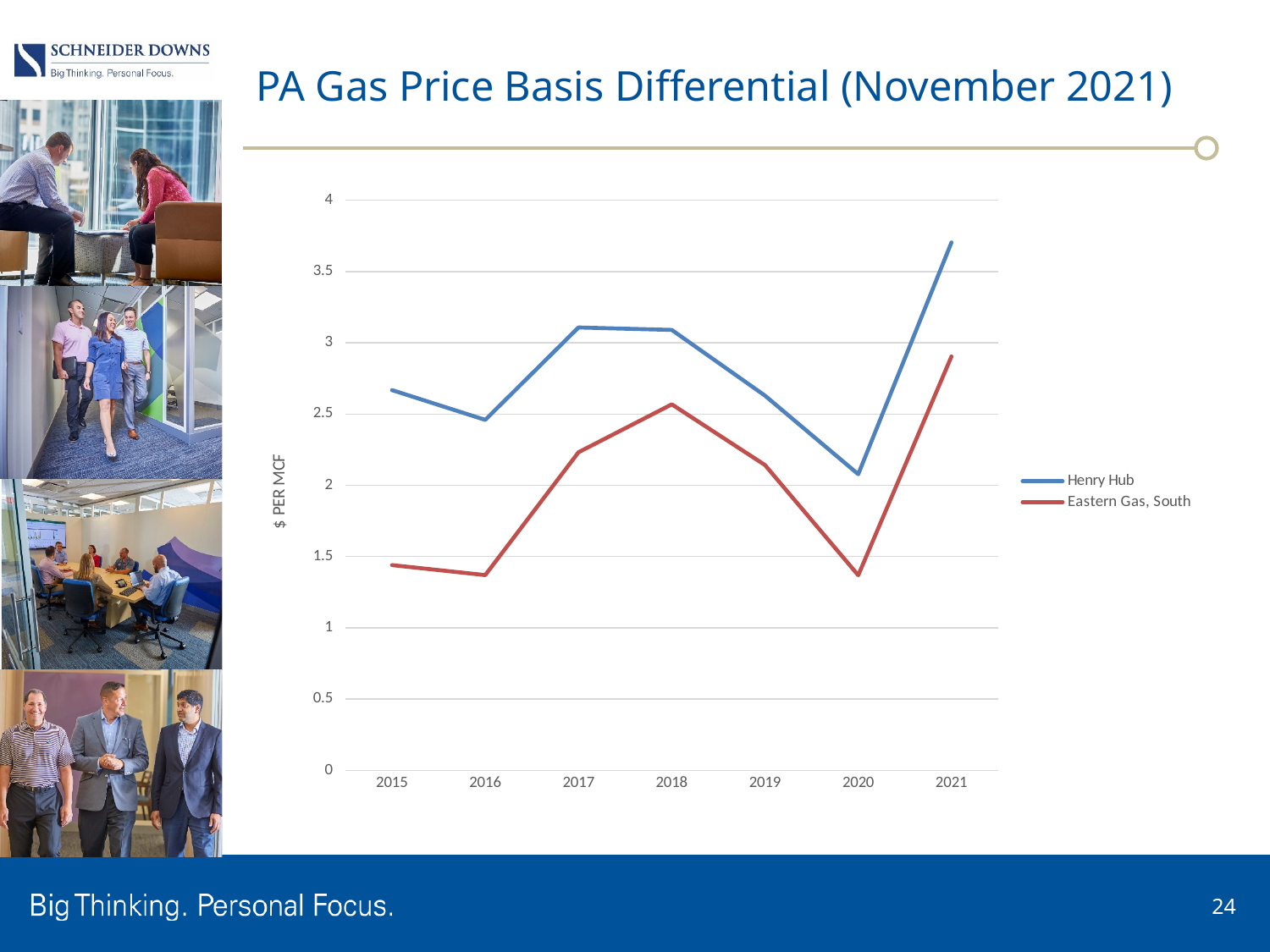
What is the label on the vertical axis of the chart? $ PER MCF Is the Henry Hub value for 2017 greater or less than 3? greater In which year does the Henry Hub line reach its highest value? 2021 What kind of chart is shown on the slide? Line chart In which year does the Henry Hub line reach its lowest value? 2020 Is the Eastern Gas, South value for 2015 greater or less than 1.5? less In which year does the Eastern Gas, South line reach its highest value? 2021 How many years are plotted along the x axis? 7 Which series has the higher value in 2018, Henry Hub or Eastern Gas, South? Henry Hub Is the Henry Hub value for 2021 greater or less than 3.5? greater Does the Eastern Gas, South line rise or fall from 2020 to 2021? Rise How many series does the legend list? 2